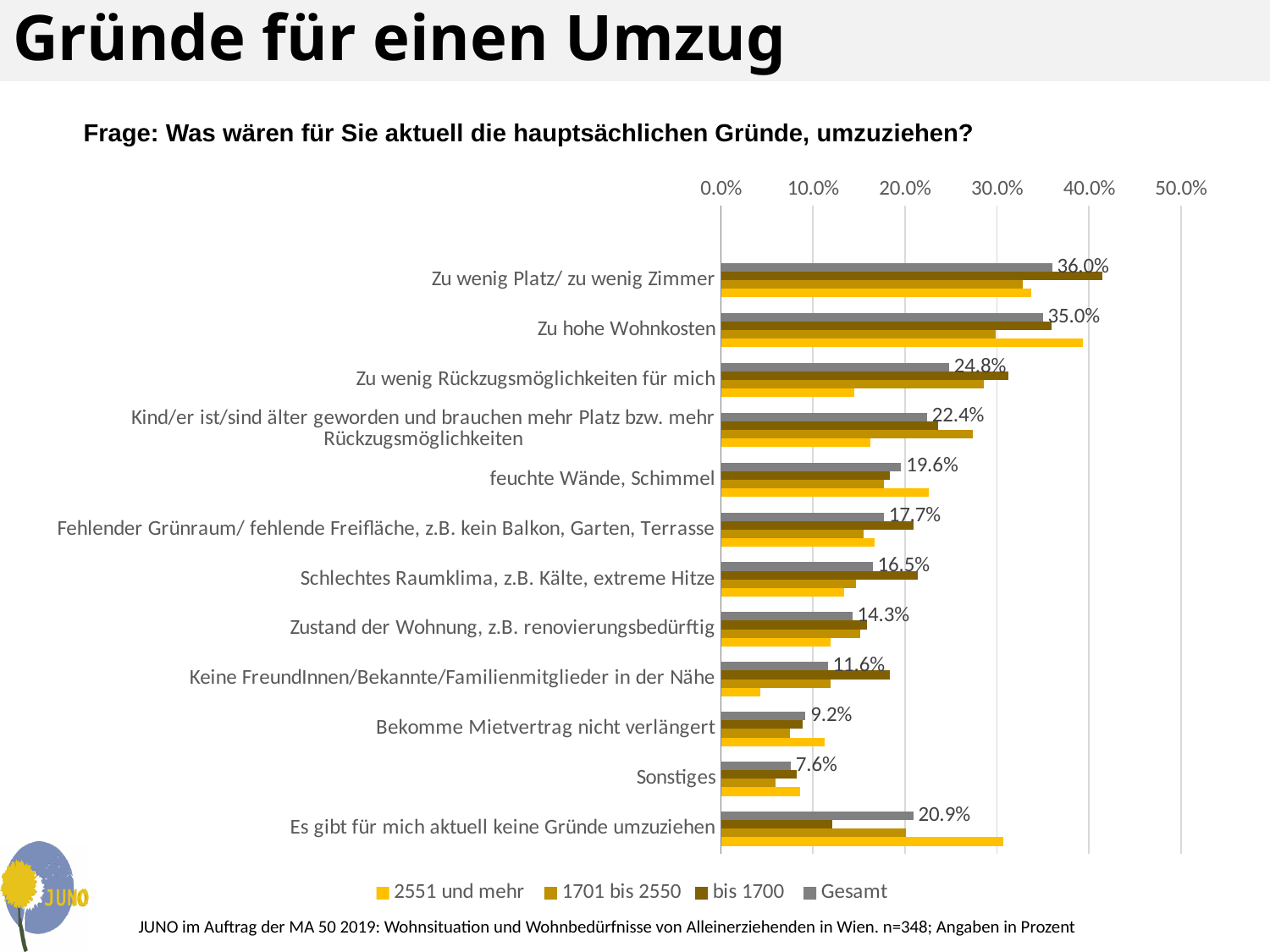
How many series does the legend list? 4 Which has a larger Gesamt value: "Schlechtes Raumklima, z.B. Kälte, extreme Hitze" or "Zustand der Wohnung, z.B. renovierungsbedürftig"? Schlechtes Raumklima, z.B. Kälte, extreme Hitze Is the value for "2551 und mehr" on "Keine FreundInnen/Bekannte/Familienmitglieder in der Nähe" greater or less than 10.0%? less What is the Gesamt value for "Es gibt für mich aktuell keine Gründe umzuziehen"? 20.9% Which category has the lowest Gesamt value? Sonstiges What is the Gesamt value for "feuchte Wände, Schimmel"? 19.6% Which category has the highest Gesamt value? Zu wenig Platz/ zu wenig Zimmer How many categories (reasons) are shown in the chart? 12 What is the difference between the Gesamt values for "Zu wenig Platz/ zu wenig Zimmer" and "Zu hohe Wohnkosten"? 1.0% What is the Gesamt value for "Zu wenig Platz/ zu wenig Zimmer"? 36.0% What kind of chart is shown on the slide? Bar chart Is the value for "2551 und mehr" on "Zu hohe Wohnkosten" greater or less than 30.0%? greater